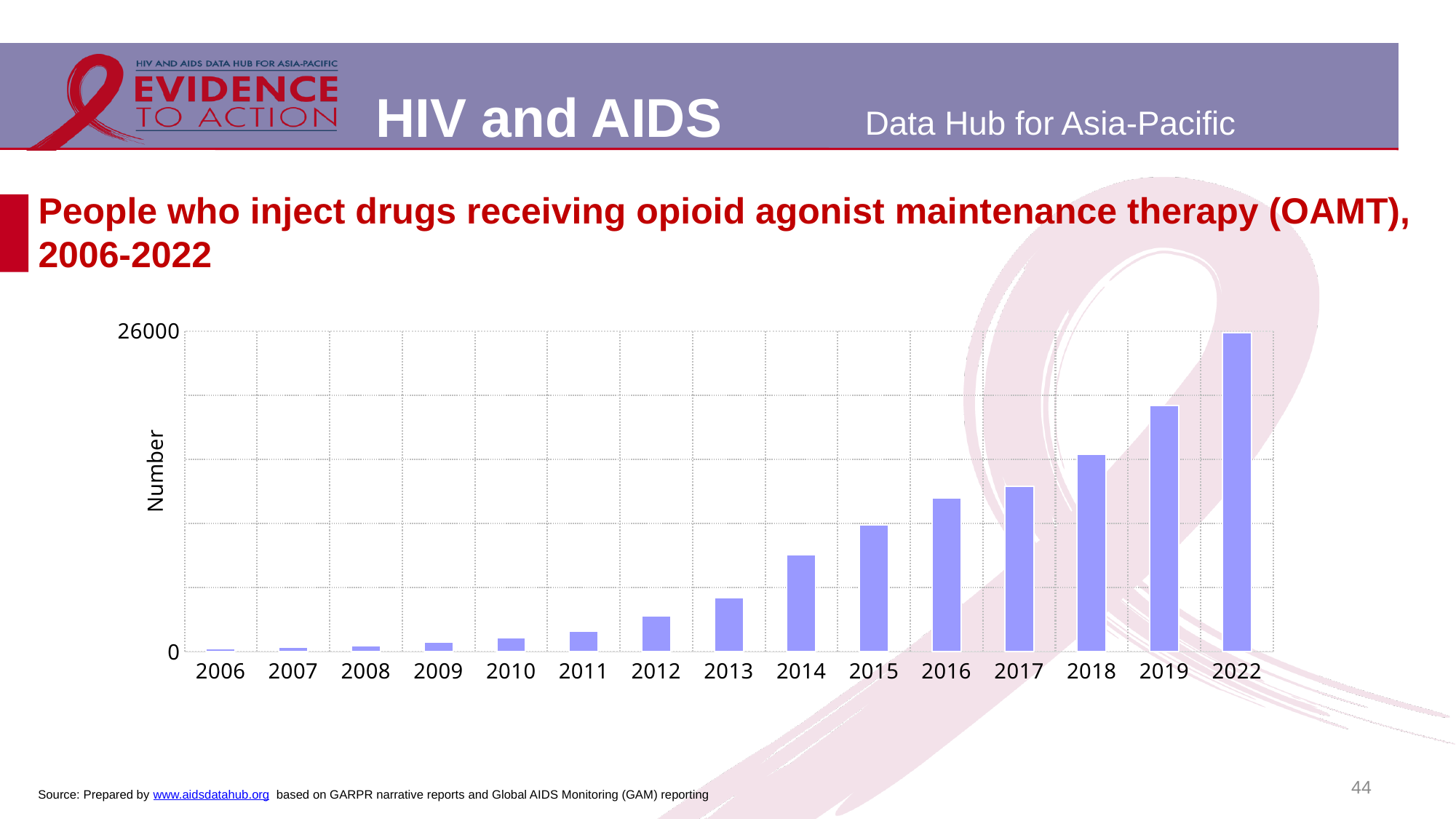
Is the value for 2014 greater or less than 26000? less Is the value for 2019 greater or less than 26000? less What is the label on the vertical axis? Number Which year has the larger value, 2013 or 2011? 2013 What is the maximum value shown on the vertical axis? 26000 Which year has the larger value, 2016 or 2018? 2018 Which year is the last one shown on the horizontal axis? 2022 What kind of chart is shown on the slide? bar chart Which year has the highest number of people who inject drugs receiving OAMT? 2022 How many years (bars) are plotted on the chart? 15 Which year has the lowest number of people who inject drugs receiving OAMT? 2006 Do the values generally rise or fall from 2006 to 2022? rise